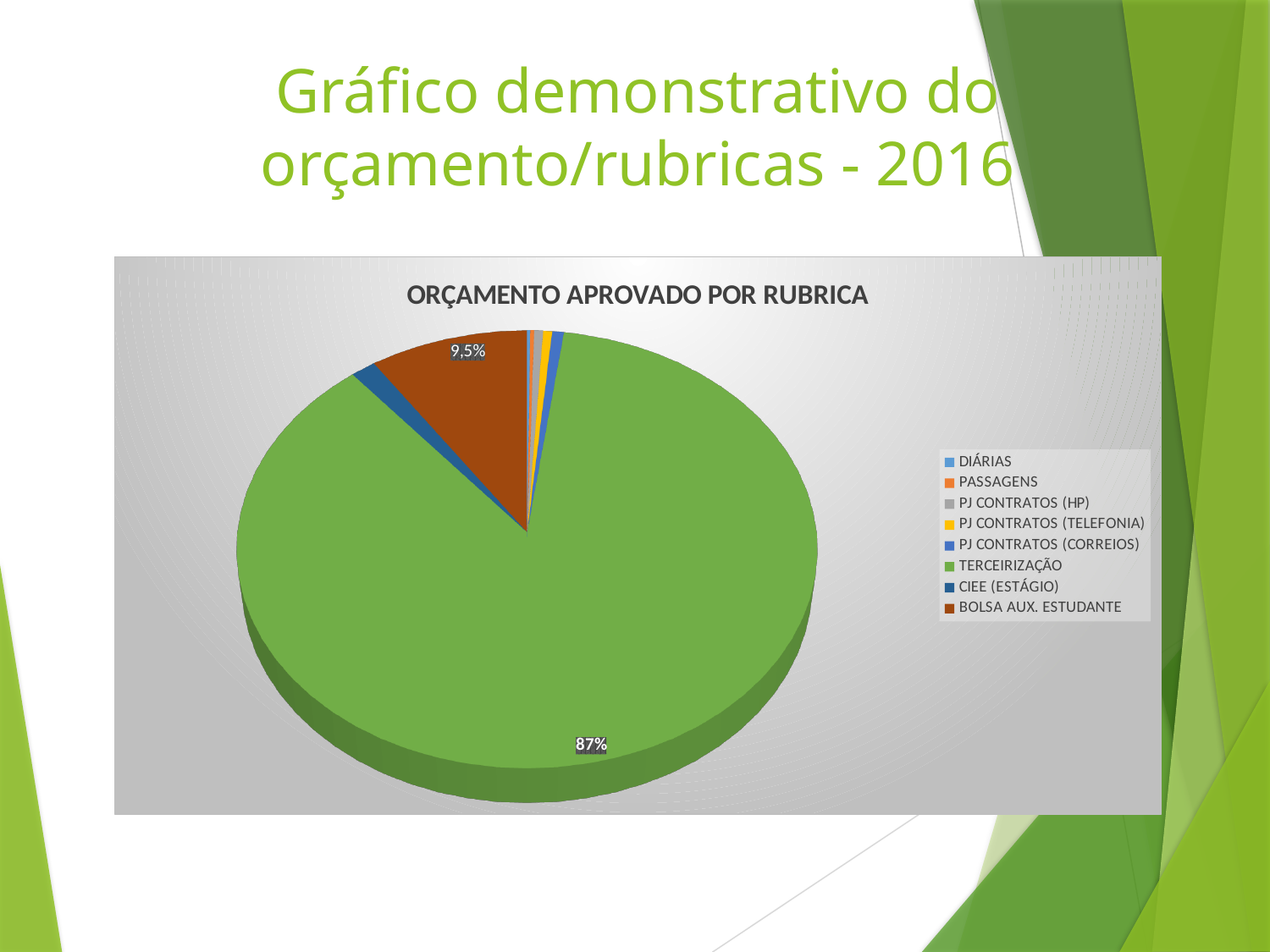
What is the title of the chart? ORÇAMENTO APROVADO POR RUBRICA What percentage of the pie does BOLSA AUX. ESTUDANTE represent? 9,5% What percentage of the pie does TERCEIRIZAÇÃO represent? 87% Which category has the largest slice of the pie? TERCEIRIZAÇÃO What colour is the slice for TERCEIRIZAÇÃO? Green Which category's slice is labelled 9,5%? BOLSA AUX. ESTUDANTE How many categories does the legend list? 8 Which is larger, the slice for TERCEIRIZAÇÃO or the slice for BOLSA AUX. ESTUDANTE? TERCEIRIZAÇÃO What is the difference in percentage points between the TERCEIRIZAÇÃO slice and the BOLSA AUX. ESTUDANTE slice? 77,5% What kind of chart is shown on the slide? Pie chart